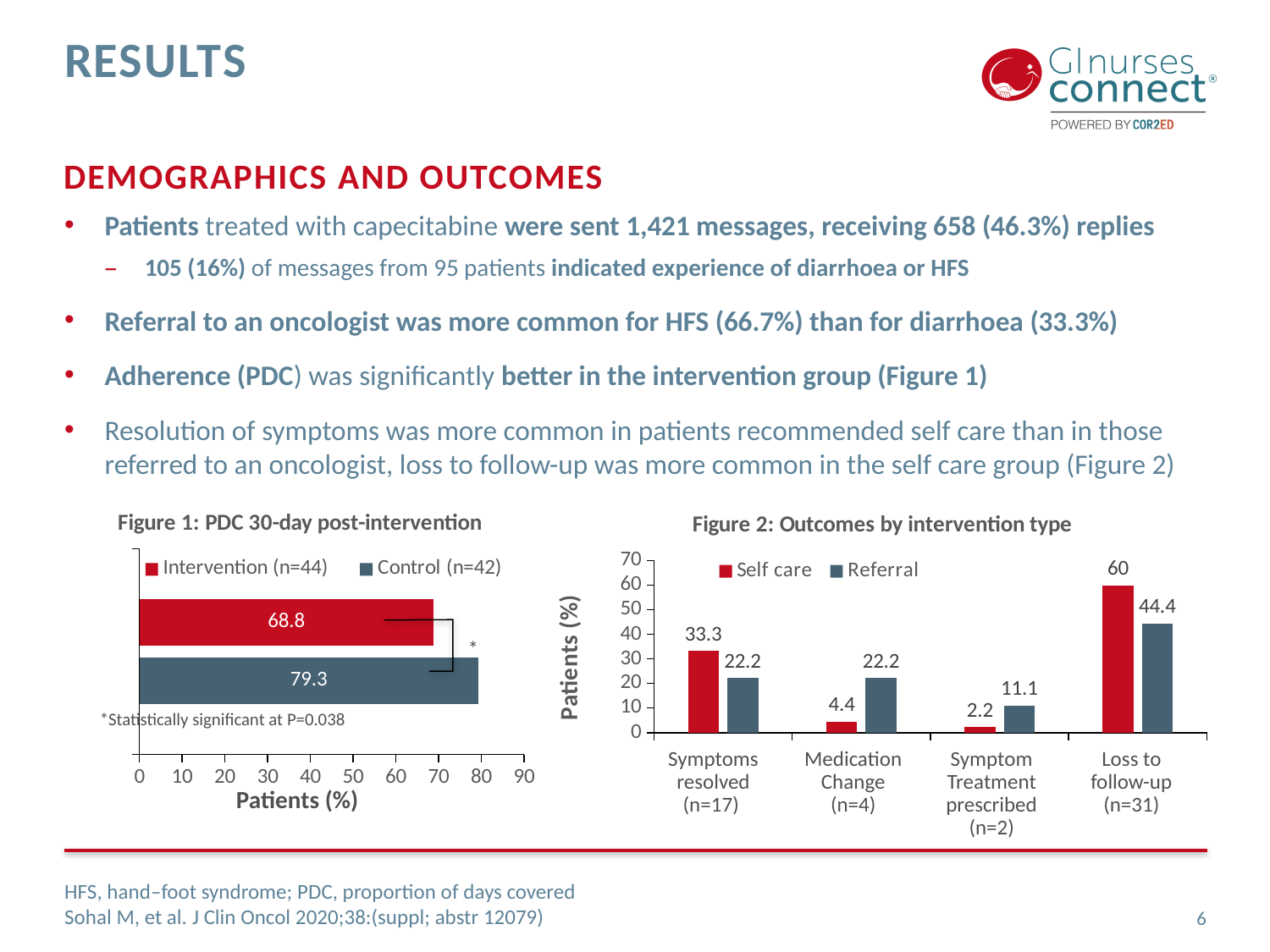
In Figure 2: Outcomes by intervention type, what is the Self care value for Symptoms resolved (n=17)? 33.3 In Figure 1: PDC 30-day post-intervention, which group has the larger value, Intervention (n=44) or Control (n=42)? Control (n=42) How many series does the legend of Figure 2: Outcomes by intervention type list? 2 In Figure 2: Outcomes by intervention type, which category has the lowest Self care value? Symptom Treatment prescribed (n=2) How many categories are shown on the x axis of Figure 2: Outcomes by intervention type? 4 In Figure 1: PDC 30-day post-intervention, what is the value for the Control (n=42) group? 79.3 In Figure 1: PDC 30-day post-intervention, what is the difference between the Control (n=42) and Intervention (n=44) values? 10.5 What kind of chart is Figure 1: PDC 30-day post-intervention? Bar chart In Figure 2: Outcomes by intervention type, what is the difference between the Self care and Referral values for Symptoms resolved (n=17)? 11.1 In Figure 2: Outcomes by intervention type, which category has the highest Self care value? Loss to follow-up (n=31) In Figure 1: PDC 30-day post-intervention, what is the value for the Intervention (n=44) group? 68.8 In Figure 2: Outcomes by intervention type, what is the Referral value for Loss to follow-up (n=31)? 44.4